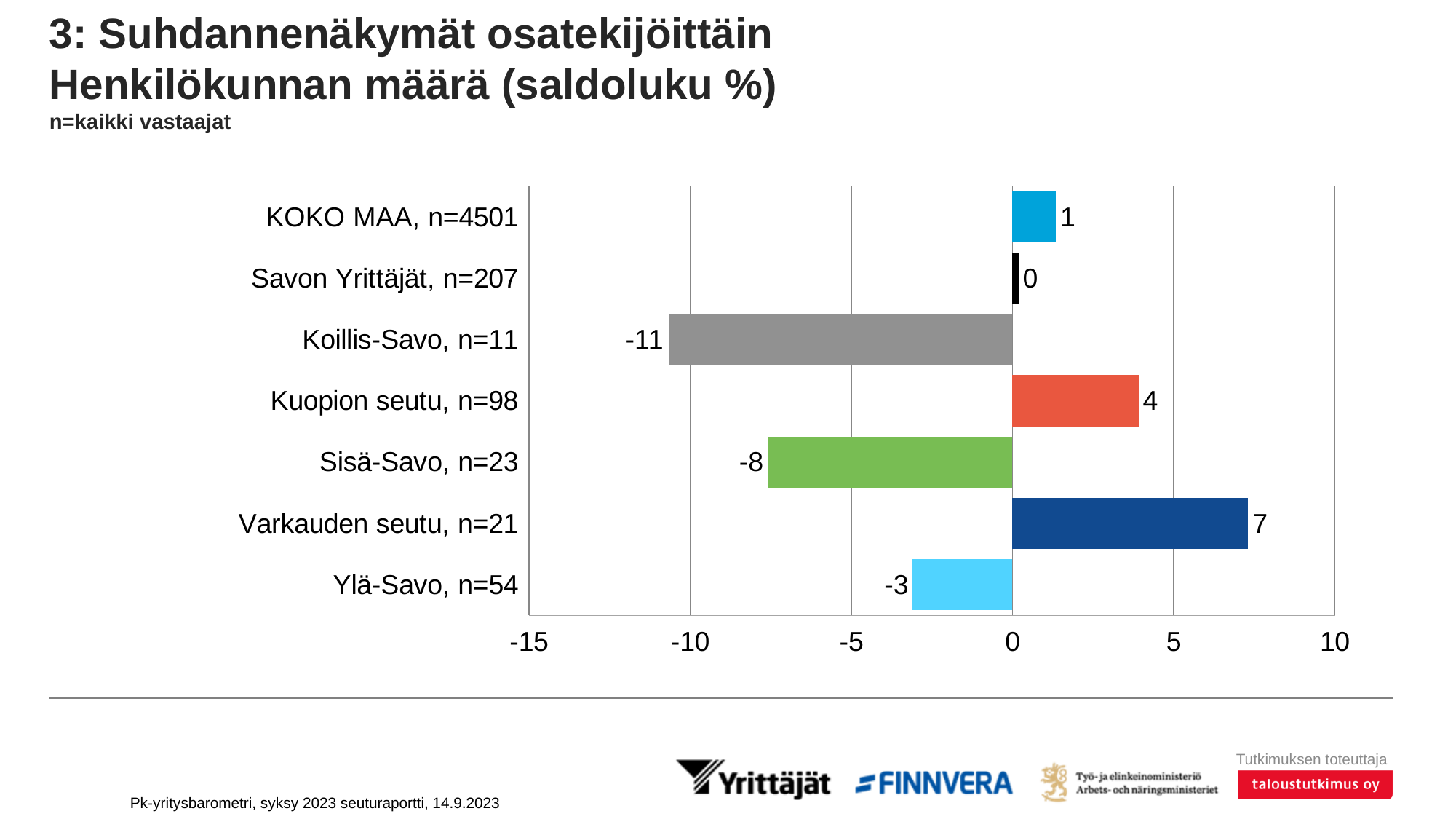
Which has a larger value, Sisä-Savo, n=23 or Ylä-Savo, n=54? Ylä-Savo, n=54 What is the value for Ylä-Savo, n=54? -3 What is the value for KOKO MAA, n=4501? 1 Which category has the lowest value? Koillis-Savo, n=11 What is the value for Koillis-Savo, n=11? -11 What is the difference between the values for Varkauden seutu, n=21 and Kuopion seutu, n=98? 3 What is the value for Savon Yrittäjät, n=207? 0 How many categories are shown in the chart? 7 Which category has the highest value? Varkauden seutu, n=21 What kind of chart is shown on the slide? bar chart Is the value for Koillis-Savo, n=11 greater or less than -10? less What is the value for Kuopion seutu, n=98? 4